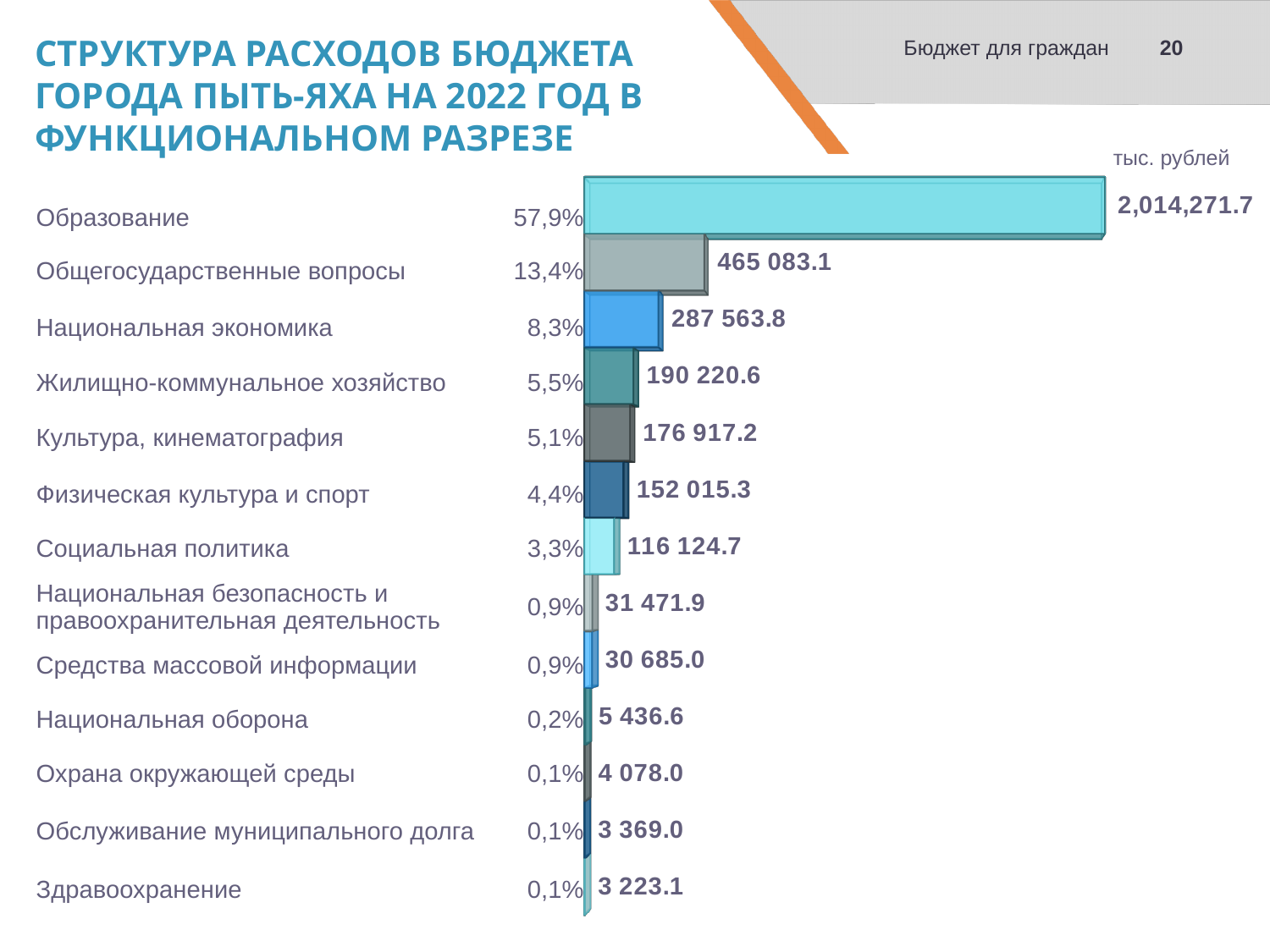
What is the value for Образование? 2,014,271.7 What is the value for Общегосударственные вопросы? 465 083.1 What kind of chart is shown on the slide? Bar chart Which category has the highest value? Образование What percentage share is shown for Национальная экономика? 8,3% What is the difference between the values for Жилищно-коммунальное хозяйство and Культура, кинематография? 13 303.4 Which category has the lowest value? Здравоохранение How many categories are shown in the chart? 13 In what units are the chart values given? тыс. рублей What is the difference between the values for Общегосударственные вопросы and Национальная экономика? 177 519.3 What is the value for Социальная политика? 116 124.7 Which is larger, the value for Физическая культура и спорт or the value for Социальная политика? Физическая культура и спорт